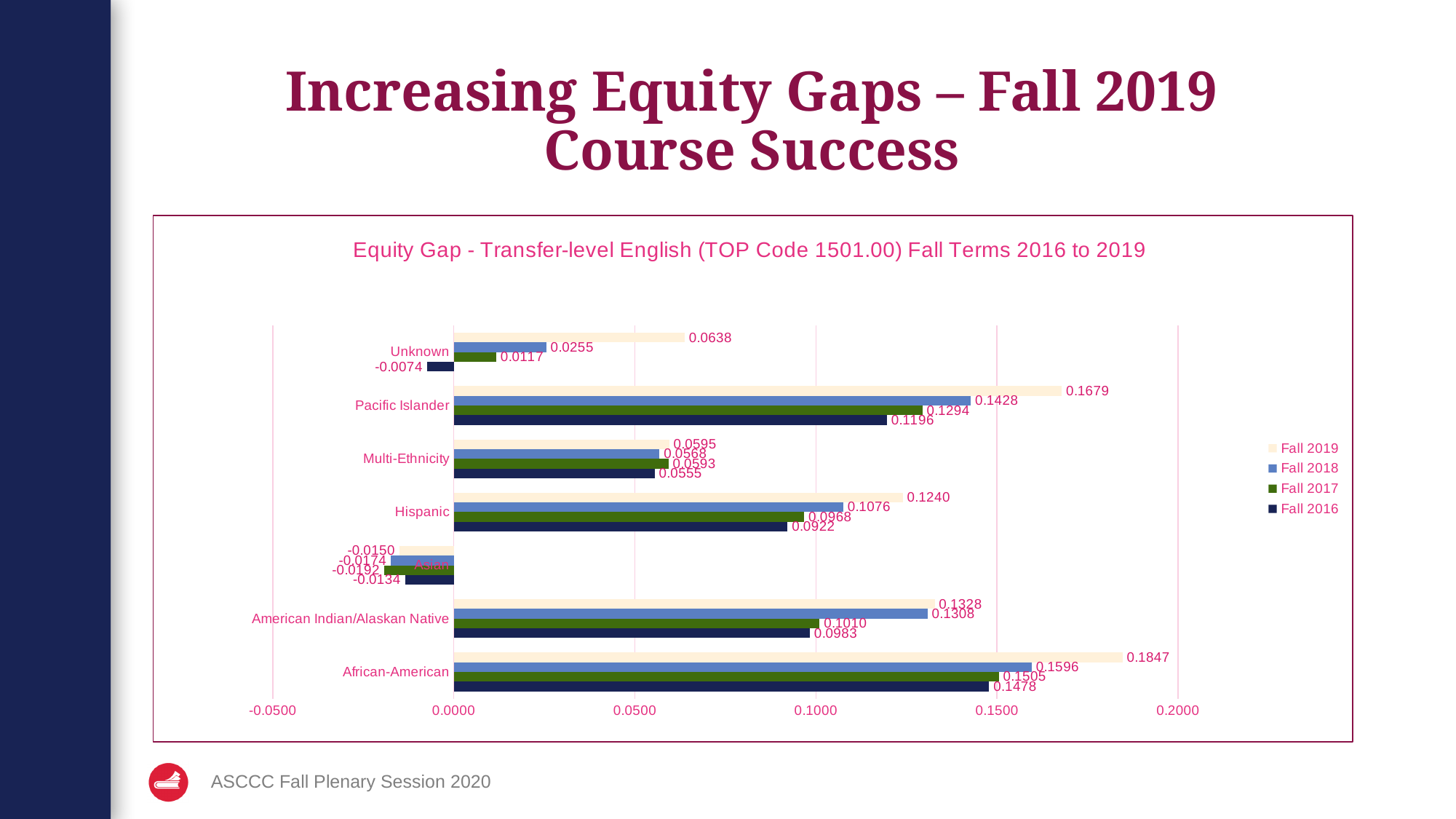
What is the title of the chart? Equity Gap - Transfer-level English (TOP Code 1501.00) Fall Terms 2016 to 2019 What is the Fall 2016 value for Pacific Islander? 0.1196 Which is larger for Unknown: the Fall 2018 value or the Fall 2017 value? Fall 2018 What is the difference between the Fall 2019 and Fall 2016 values for Hispanic? 0.0318 How many categories are shown on the chart? 7 What is the Fall 2019 value for African-American? 0.1847 How many series does the legend list? 4 What kind of chart is shown on the slide? Bar chart What is the Fall 2018 value for Hispanic? 0.1076 Which category has the highest Fall 2019 value? African-American What is the Fall 2017 value for Asian? -0.0192 Which category has the lowest Fall 2018 value? Asian